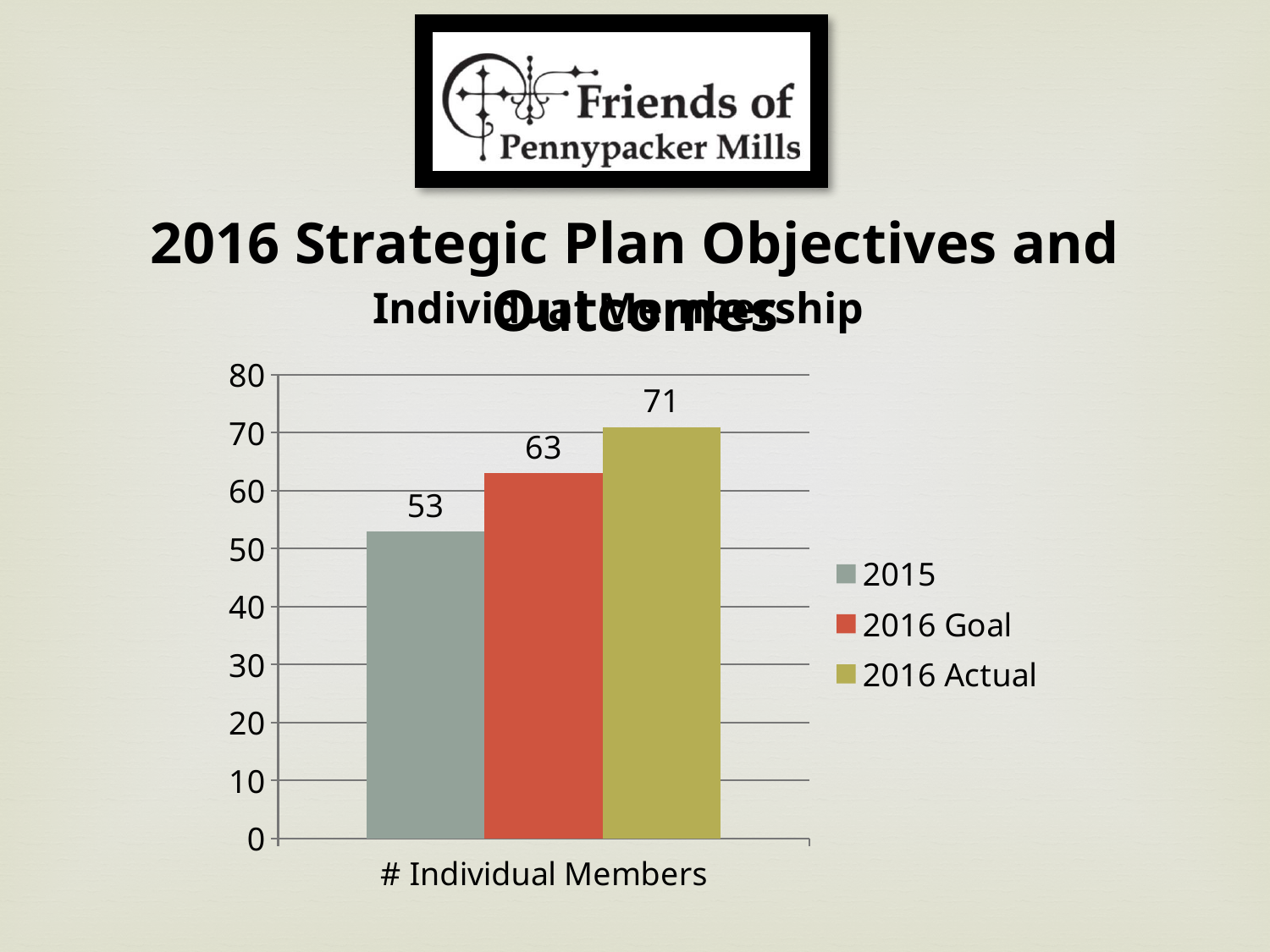
What is the difference between the 2016 Actual value and the 2016 Goal value? 8 How many series does the legend list? 3 What is the difference between the 2016 Goal value and the 2015 value? 10 What is the category label shown on the x axis of the chart? # Individual Members Which series has the highest value in the chart? 2016 Actual What is the value for the 2015 series in the chart? 53 What kind of chart is shown on the slide? bar chart What is the value for the 2016 Goal series in the chart? 63 Which is larger, the 2016 Actual value or the 2015 value? 2016 Actual Which series has the lowest value in the chart? 2015 What is the value for the 2016 Actual series in the chart? 71 Is the value for 2016 Actual greater or less than 70? greater